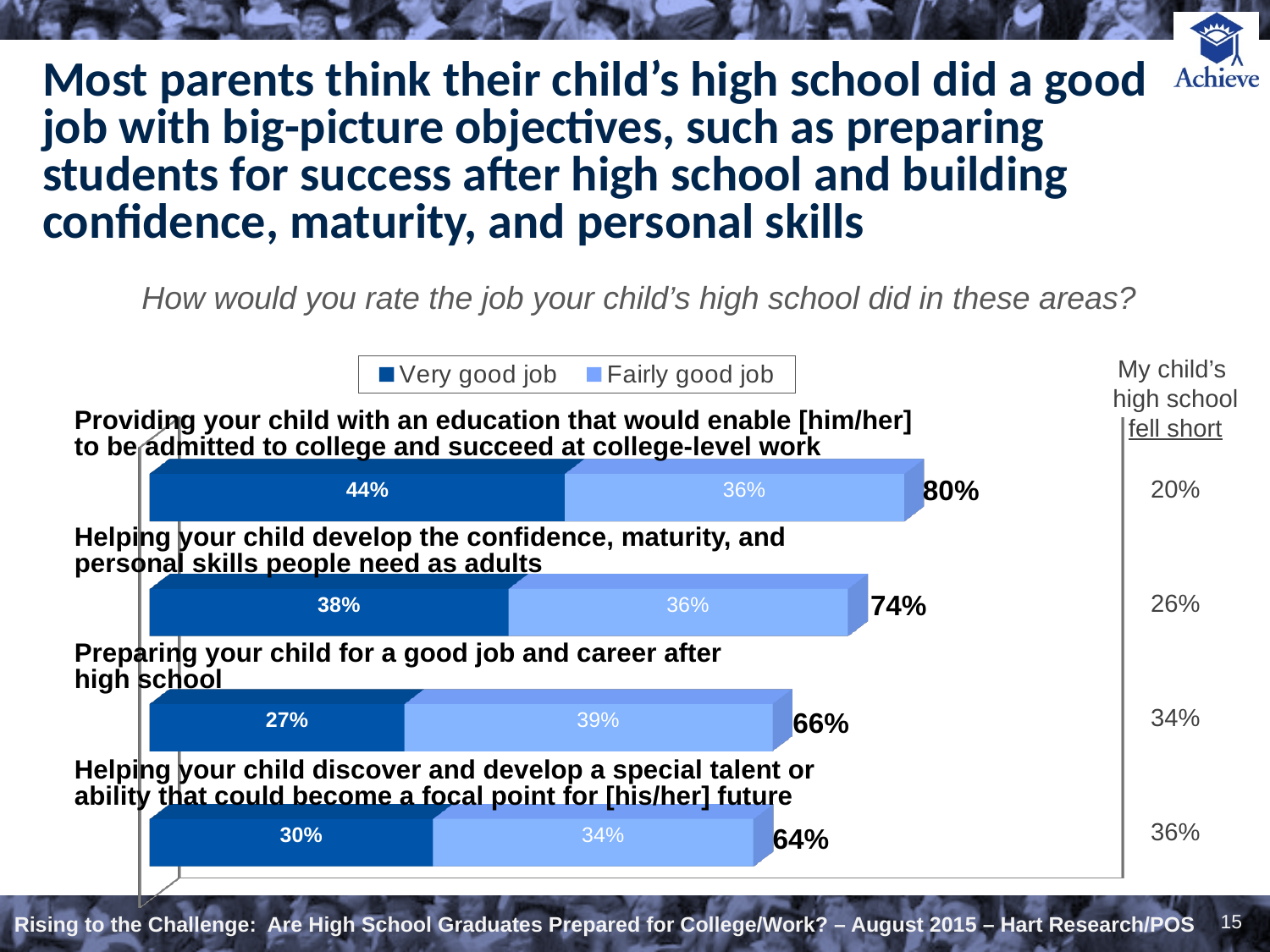
According to the 'My child's high school fell short' column, what percentage of parents said the school fell short in helping their child discover and develop a special talent or ability? 36% Which area has the lowest 'Very good job' percentage? Preparing your child for a good job and career after high school Which is larger: the 'Fairly good job' share for preparing the child for a good job and career (39%) or for discovering a special talent (34%)? Preparing your child for a good job and career after high school (39%) How many series does the legend list? 2 How many areas (categories) are rated in the chart? 4 What are the two legend entries in the chart? Very good job; Fairly good job What is the combined very good/fairly good total for helping the child develop the confidence, maturity, and personal skills people need as adults? 74% What type of chart is shown on the slide? Stacked horizontal bar chart What percentage of parents said the high school did a very good job providing an education that would enable their child to be admitted to college and succeed at college-level work? 44% What is the difference between the 'Very good job' percentages for the college-readiness area (44%) and the special talent area (30%)? 14 percentage points Which area has the highest combined very good/fairly good rating? Providing your child with an education that would enable [him/her] to be admitted to college and succeed at college-level work What percentage of parents said the high school did a fairly good job preparing their child for a good job and career after high school? 39%